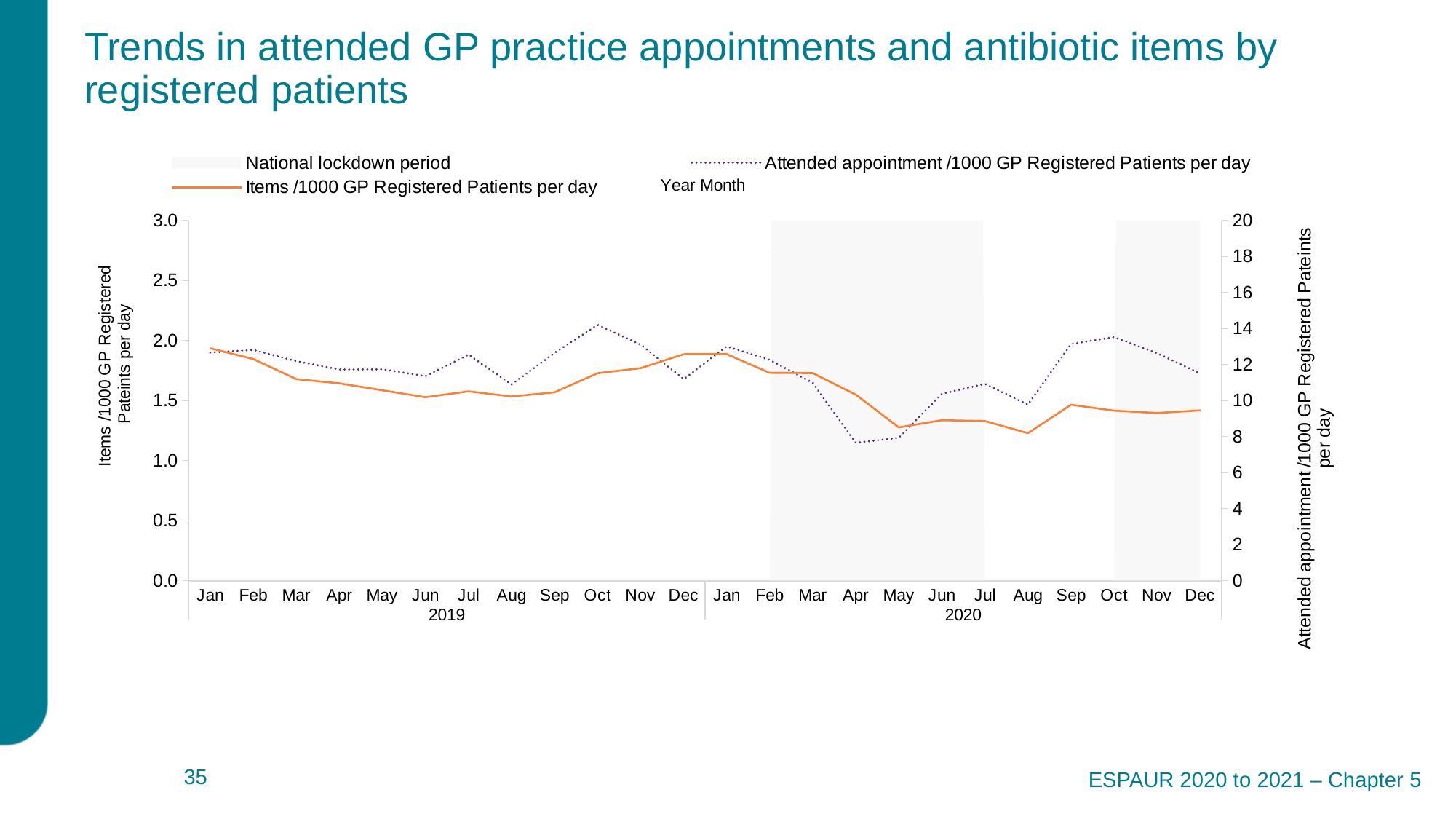
Is the value for Items /1000 GP Registered Patients per day in Jan 2019 greater or less than 1.5? greater How many months are shown along the x axis? 24 Which series is drawn as a dotted line? Attended appointment /1000 GP Registered Patients per day What does the grey shaded area on the chart represent? National lockdown period Is the value for Attended appointment /1000 GP Registered Patients per day in Oct 2019 greater or less than 12? greater How many line series are plotted on the chart? 2 Is the value for Items /1000 GP Registered Patients per day in May 2020 greater or less than 1.5? less What kind of chart is shown on the slide? Line chart Does the Items /1000 GP Registered Patients per day series rise or fall from Jan 2019 to Jun 2019? Fall In which month is the Attended appointment /1000 GP Registered Patients per day series at its lowest? Apr 2020 Which is larger for Items /1000 GP Registered Patients per day: Jan 2019 or May 2020? Jan 2019